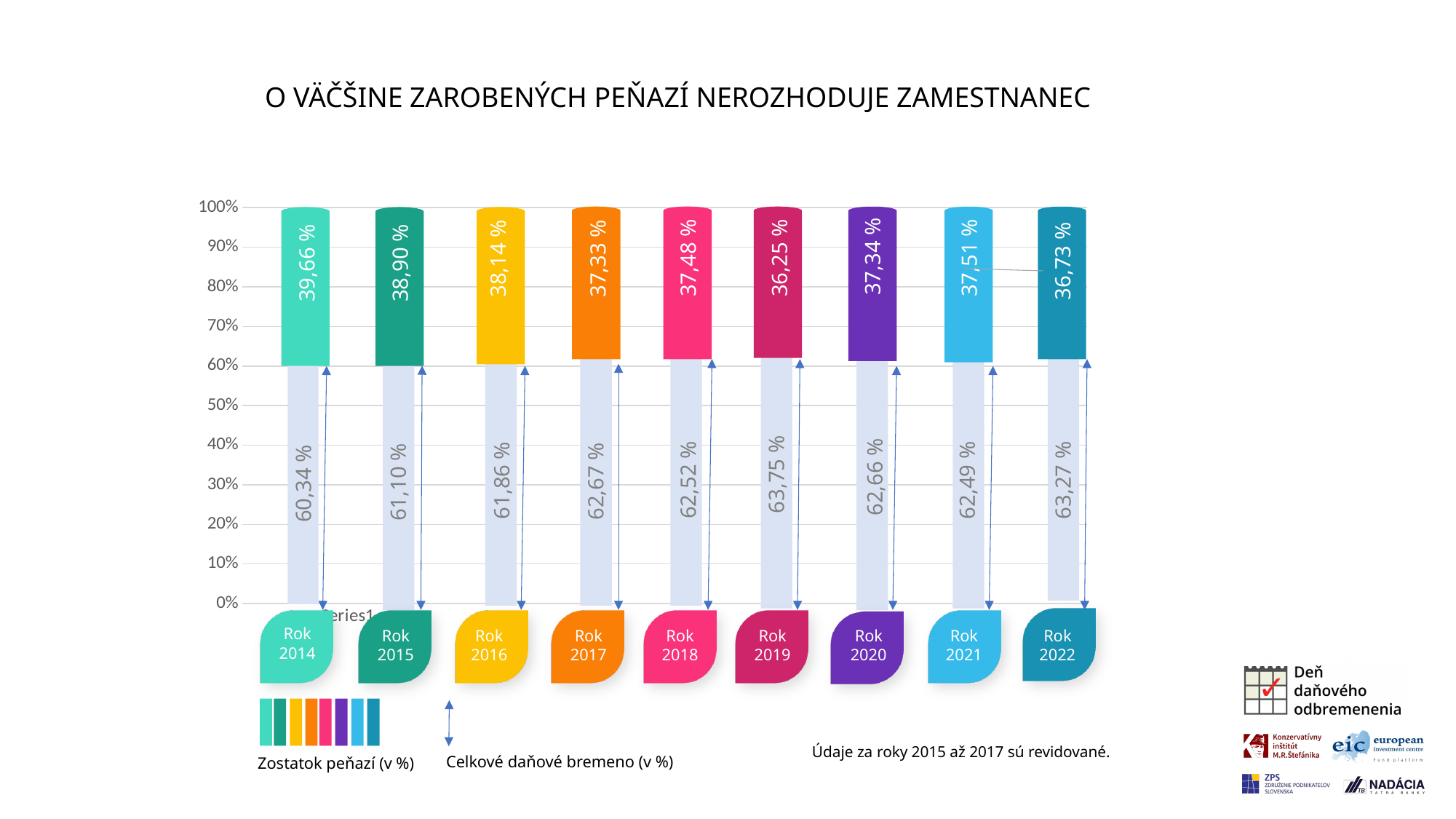
What kind of chart is shown on the slide? Stacked bar chart What is the difference between the Zostatok peňazí (v %) values for Rok 2014 and Rok 2022? 2,93 % Which is larger, the Zostatok peňazí (v %) value for Rok 2015 or for Rok 2021? Rok 2015 Does the Celkové daňové bremeno (v %) value generally rise or fall from Rok 2014 to Rok 2022? Rise Which year has the lowest value of Zostatok peňazí (v %)? Rok 2019 What is the value of Zostatok peňazí (v %) for Rok 2014? 39,66 % What is the value of Celkové daňové bremeno (v %) for Rok 2019? 63,75 % What is the value of Celkové daňové bremeno (v %) for Rok 2022? 63,27 % How many years are shown on the x axis of the chart? 9 What is the total of the stacked bar for Rok 2018? 100% Which year has the highest value of Zostatok peňazí (v %)? Rok 2014 Which year has the lowest value of Celkové daňové bremeno (v %)? Rok 2014